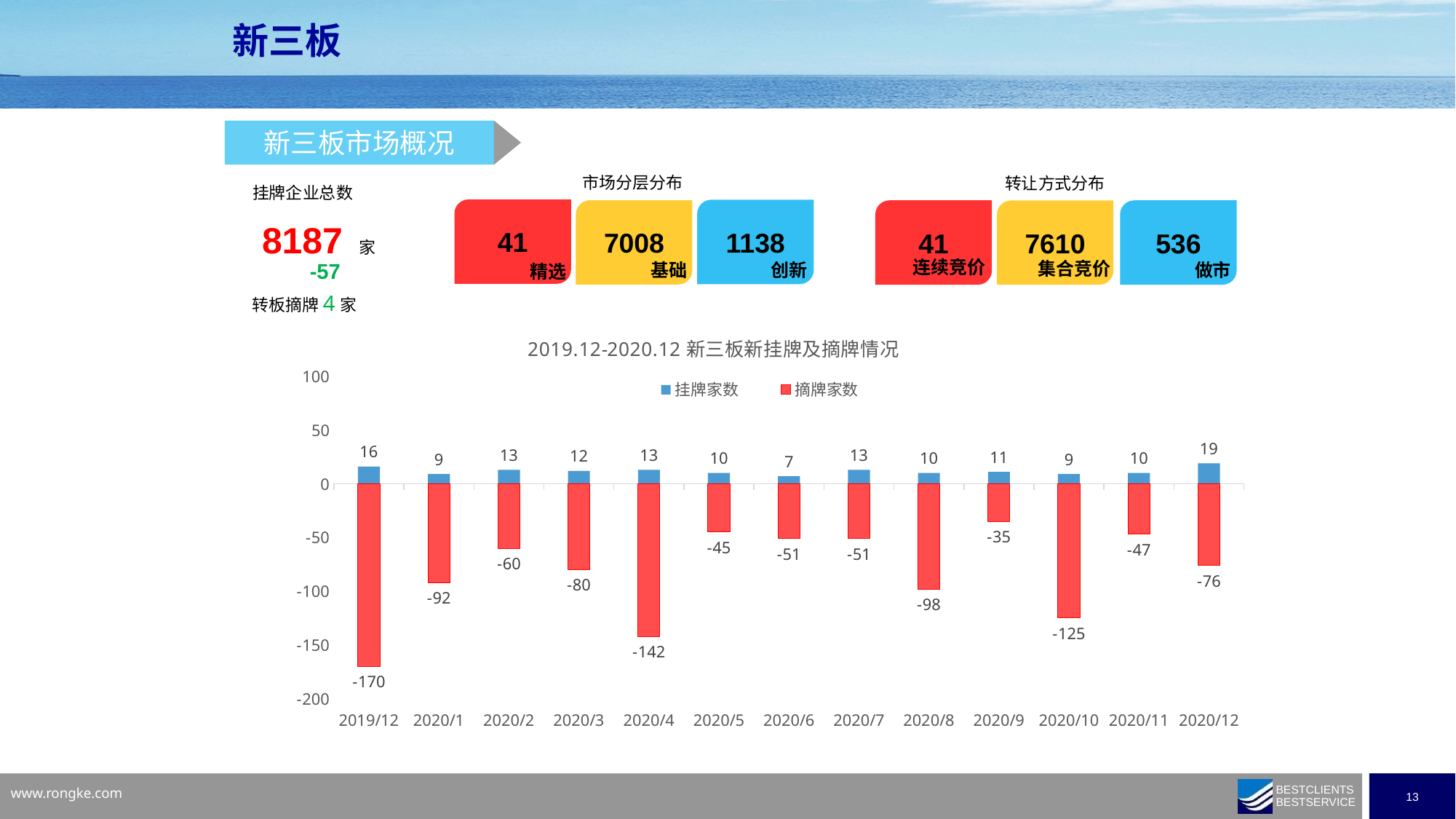
Which is larger in magnitude, 摘牌家数 for 2020/10 or for 2020/8? 2020/10 Which month has the smallest 摘牌家数 value (the most negative)? 2019/12 What is the value of 挂牌家数 for 2020/12? 19 How many series does the chart legend list? 2 What is the value of 摘牌家数 for 2020/4? -142 Which month has the lowest 挂牌家数? 2020/6 What is the difference between 挂牌家数 for 2020/12 and 2020/1? 10 What is the value of 摘牌家数 for 2019/12? -170 How many months are shown on the x axis of the chart? 13 Which month has the highest 挂牌家数? 2020/12 What type of chart is used for 2019.12-2020.12 新三板新挂牌及摘牌情况? Bar chart What is the value of 挂牌家数 for 2020/6? 7